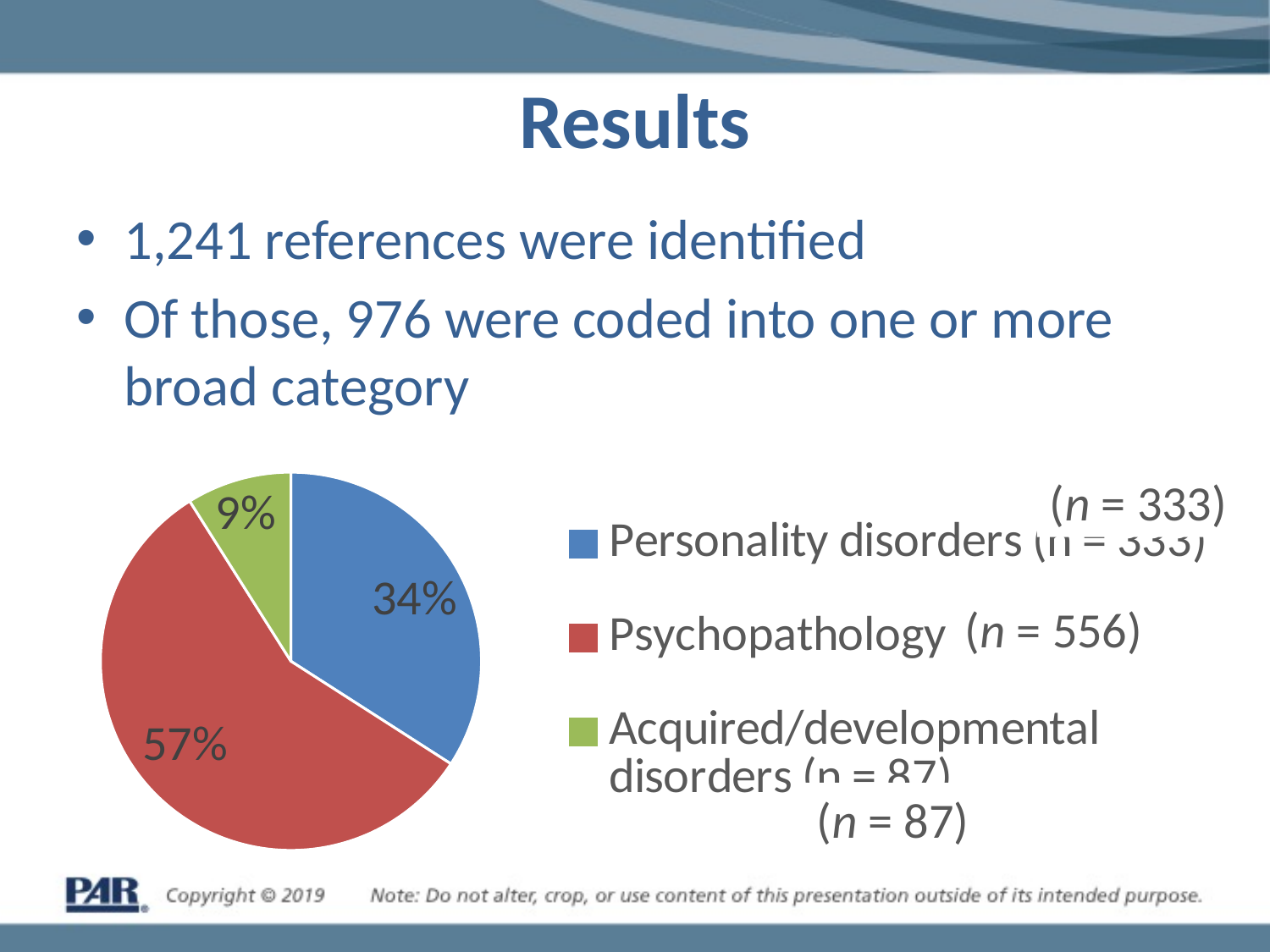
What is the combined share of the Personality disorders and Acquired/developmental disorders slices? 43% What share of the pie does Psychopathology represent? 57% What is the difference in percentage points between the Psychopathology and Personality disorders slices? 23 Which category has the largest slice of the pie? Psychopathology What share of the pie does Personality disorders represent? 34% Which slice is larger, Personality disorders or Acquired/developmental disorders? Personality disorders What colour is the Psychopathology slice? red What colour is the Acquired/developmental disorders slice? green How many categories does the pie chart show? 3 Which category has the smallest slice of the pie? Acquired/developmental disorders What share of the pie does Acquired/developmental disorders represent? 9% What kind of chart is shown on the slide? pie chart